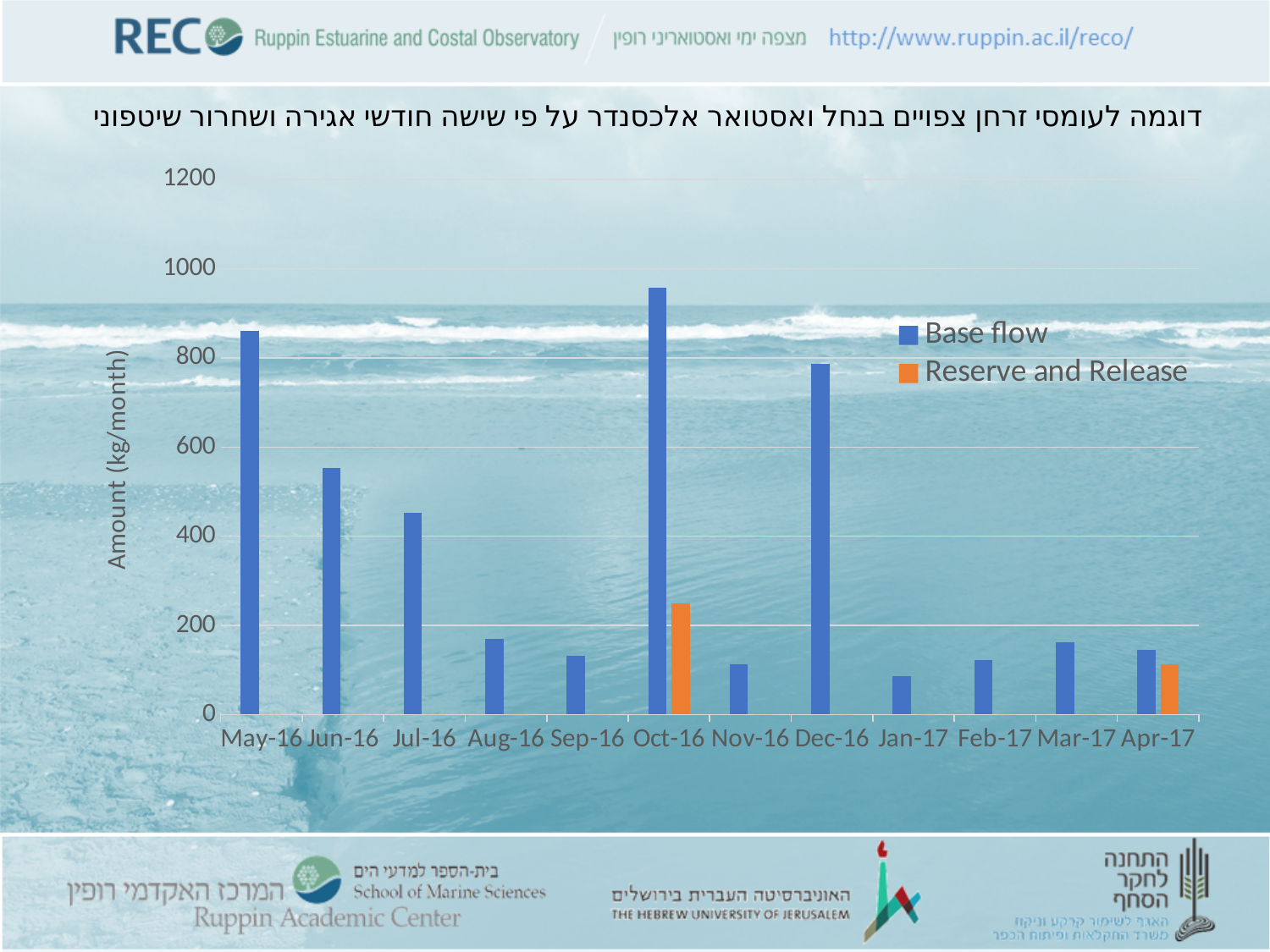
Is the Base flow value for Oct-16 greater or less than 1000? less Which month has the lowest Base flow value? Jan-17 How many series does the chart's legend list? 2 Is the Base flow value for Jun-16 greater or less than 600? less How many months are shown along the x axis of the chart? 12 What is the label of the y axis? Amount (kg/month) Is the Reserve and Release value for Oct-16 greater or less than 200? greater What kind of chart is shown on the slide? bar chart Which is larger, the Base flow value for Dec-16 or for Jul-16? Dec-16 Which series is shown in orange in the chart? Reserve and Release Which month has the highest Base flow value? Oct-16